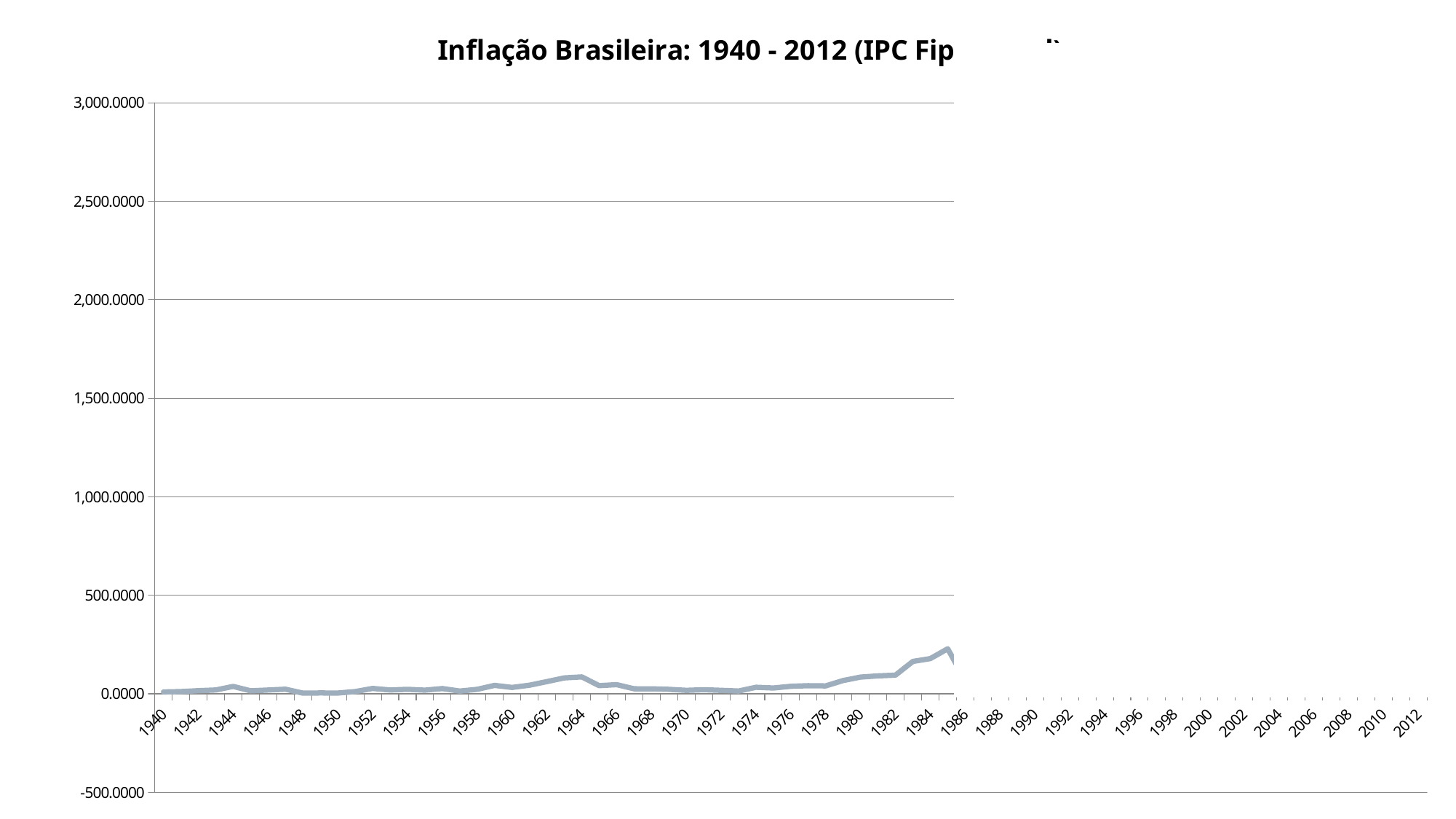
Is the value for 1964 greater or less than 500? less Between 1964 and 1966, does the line rise or fall? fall What is the lowest value labelled on the vertical axis? -500.0000 Which year has the larger plotted value, 1964 or 1984? 1984 What is the first year labelled on the horizontal axis? 1940 Is the value for 1984 greater or less than 0? greater Between 1978 and 1984, does the line rise or fall? rise Is the value for 1984 greater or less than 500? less In which decade does the line reach its highest point: the 1940s, the 1960s, or the 1980s? 1980s What is the highest value labelled on the vertical axis? 3,000.0000 What kind of chart is shown on the slide? line chart Which year has the larger plotted value, 1944 or 1948? 1944